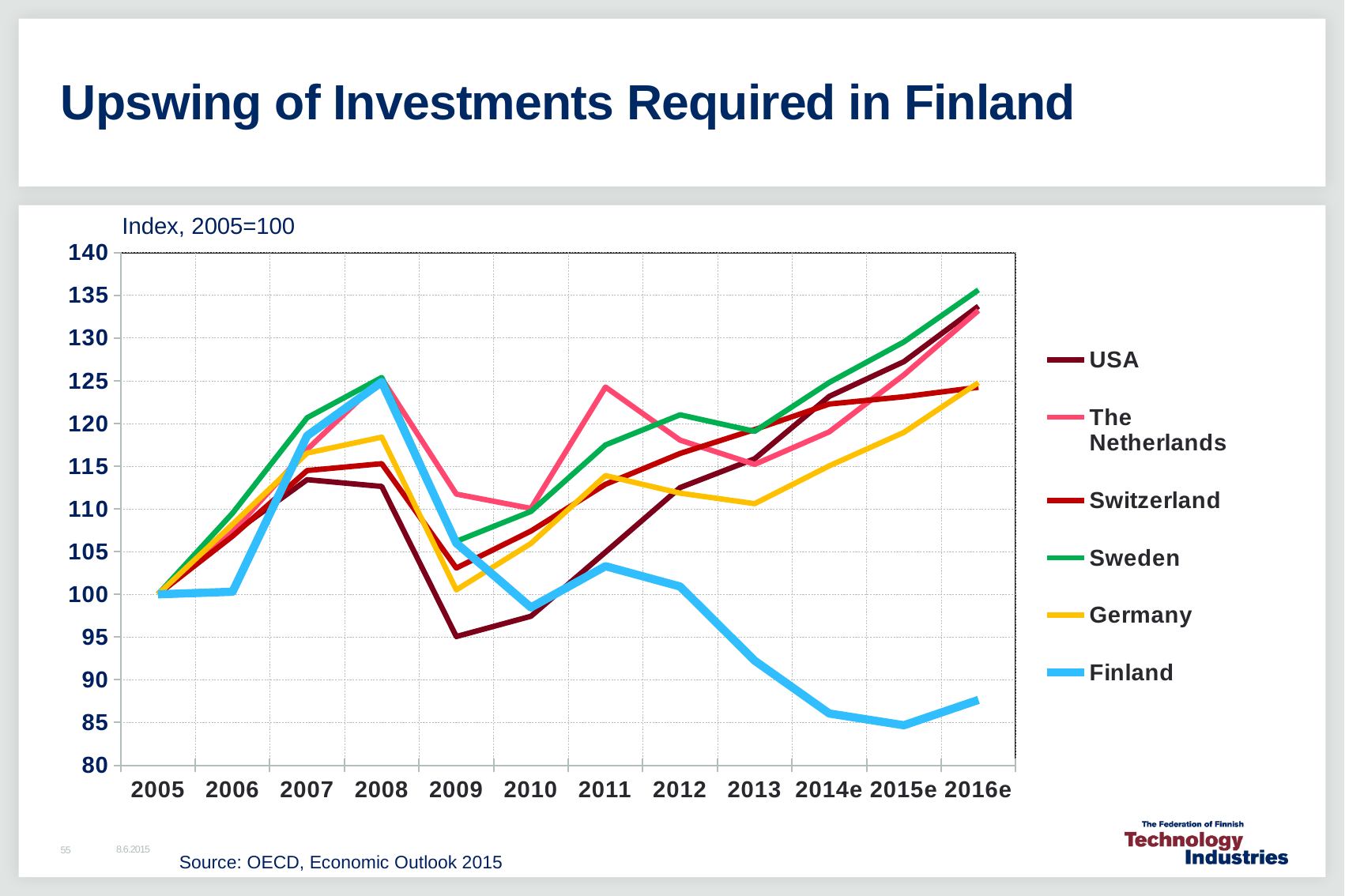
Is the value for USA in 2009 greater or less than 100? less What kind of chart is shown on the slide? line chart Which series has the lowest value in 2016e? Finland Is the value for Sweden in 2016e greater or less than 130? greater In 2013, which is larger: the value for Finland or the value for Germany? Germany Which series has the highest value in 2016e? Sweden How many series does the legend list? 6 In 2011, which is larger: the value for The Netherlands or the value for Sweden? The Netherlands How many years are shown along the x axis? 12 Is the value for Finland in 2015e greater or less than 90? less What is the index value for Finland in 2005? 100 Does the Finland line rise or fall from 2012 to 2015e? fall